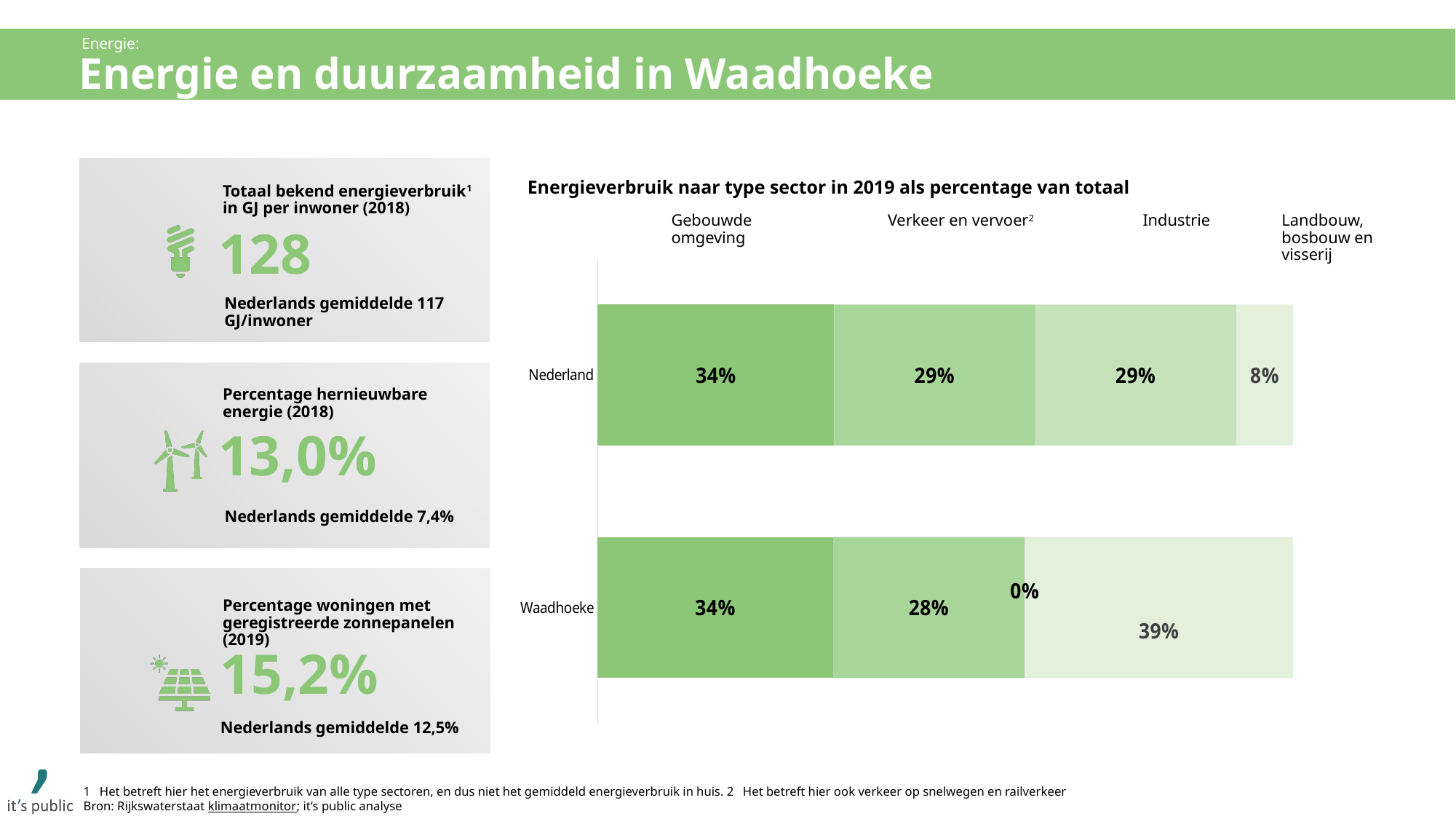
What percentage of Waadhoeke's energy consumption comes from Landbouw, bosbouw en visserij? 39% Which region has the larger share of energy consumption from Industrie, Nederland or Waadhoeke? Nederland Which sector has the largest share of energy consumption in Waadhoeke? Landbouw, bosbouw en visserij What percentage of Waadhoeke's energy consumption comes from Industrie? 0% How many regions (bars) are shown in the chart? 2 Which sector has the smallest share of energy consumption in Nederland? Landbouw, bosbouw en visserij How many sector types are shown in the chart? 4 What percentage of Nederland's energy consumption comes from Gebouwde omgeving? 34% What is the difference between the Landbouw, bosbouw en visserij share for Waadhoeke and for Nederland? 31 percentage points What is the title of the chart on the right of the slide? Energieverbruik naar type sector in 2019 als percentage van totaal What type of chart is used to show energy consumption by sector type in 2019? stacked bar chart What percentage of Nederland's energy consumption comes from Verkeer en vervoer? 29%